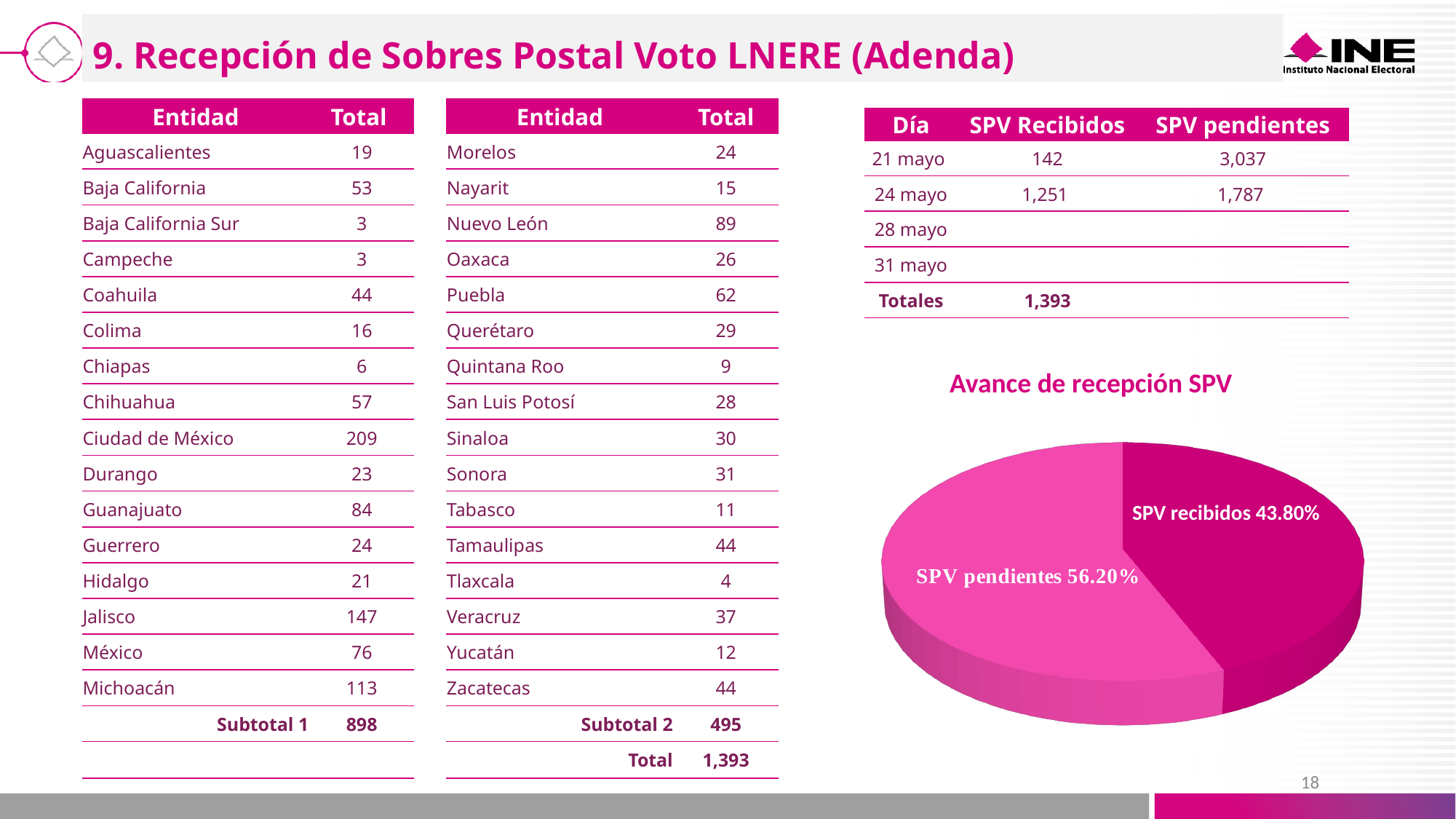
In the pie chart, what share is labelled for SPV pendientes? 56.20% How many slices does the pie chart have? 2 What kind of chart is shown under the title "Avance de recepción SPV"? pie chart What is the title of the pie chart on the slide? Avance de recepción SPV Which slice of the pie chart is the smallest? SPV recibidos Is the share for SPV recibidos in the pie chart greater or less than 50%? less In the pie chart, which is larger: SPV recibidos or SPV pendientes? SPV pendientes Which slice of the pie chart is the largest? SPV pendientes What is the difference in percentage points between the SPV pendientes and SPV recibidos slices of the pie chart? 12.40% What do the two slice labels of the pie chart read? SPV recibidos 43.80% and SPV pendientes 56.20% In the pie chart, what share is labelled for SPV recibidos? 43.80% Is the share for SPV pendientes in the pie chart greater or less than 50%? greater